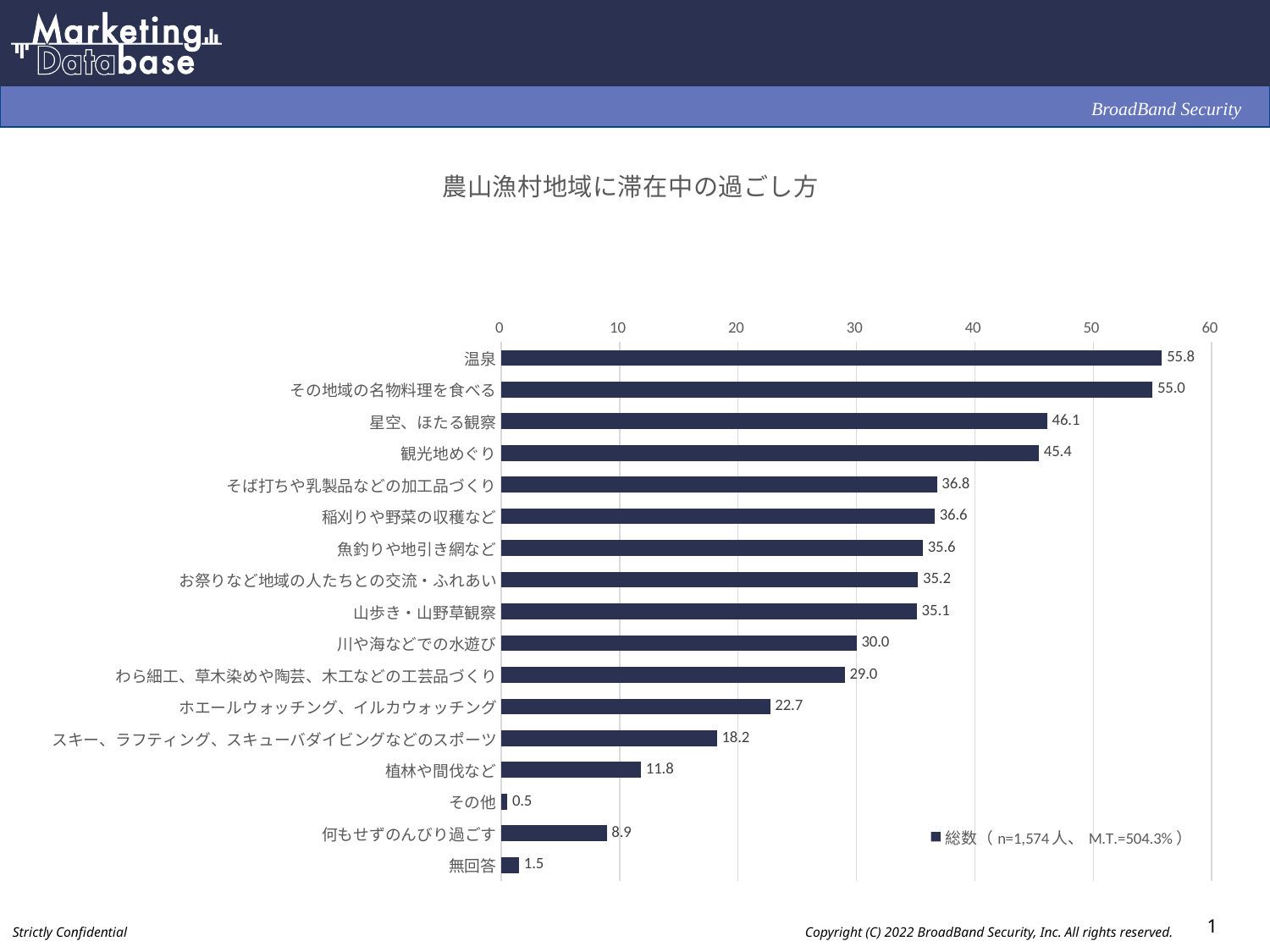
What is the difference between the values for 温泉 and その地域の名物料理を食べる? 0.8 What is the title of the chart? 農山漁村地域に滞在中の過ごし方 What kind of chart is shown on the slide? bar chart Is the value for わら細工、草木染めや陶芸、木工などの工芸品づくり greater or less than 30? less How many categories are shown in the chart? 17 What is the value for 星空、ほたる観察? 46.1 Which category has the lowest value? その他 Which category has the highest value? 温泉 Which is larger, the value for ホエールウォッチング、イルカウォッチング or the value for スキー、ラフティング、スキューバダイビングなどのスポーツ? ホエールウォッチング、イルカウォッチング What is the value for 温泉? 55.8 What is the difference between the values for 観光地めぐり and 川や海などでの水遊び? 15.4 What is the value for 植林や間伐など? 11.8